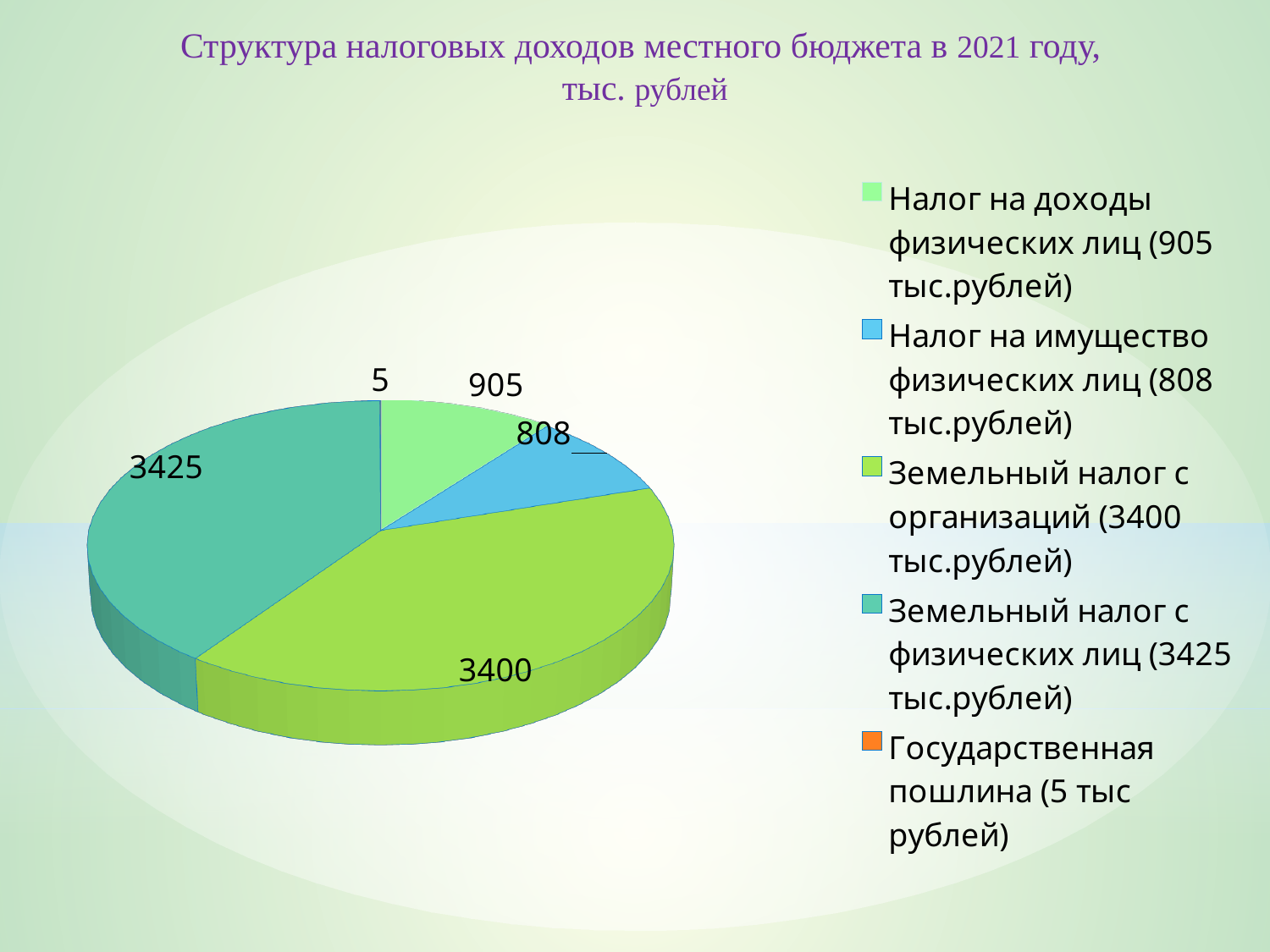
What type of chart is shown on the slide? Pie chart What is the value for Государственная пошлина? 5 What is the value for Земельный налог с организаций? 3400 What is the value for Налог на доходы физических лиц? 905 Which category has the smallest value? Государственная пошлина What is the difference between Земельный налог с физических лиц and Земельный налог с организаций? 25 What is the value for Налог на имущество физических лиц? 808 What is the title of the chart? Структура налоговых доходов местного бюджета в 2021 году, тыс. рублей What is the value for Земельный налог с физических лиц? 3425 Which is larger: Налог на доходы физических лиц or Налог на имущество физических лиц? Налог на доходы физических лиц How many categories does the legend list? 5 Which category has the largest value? Земельный налог с физических лиц